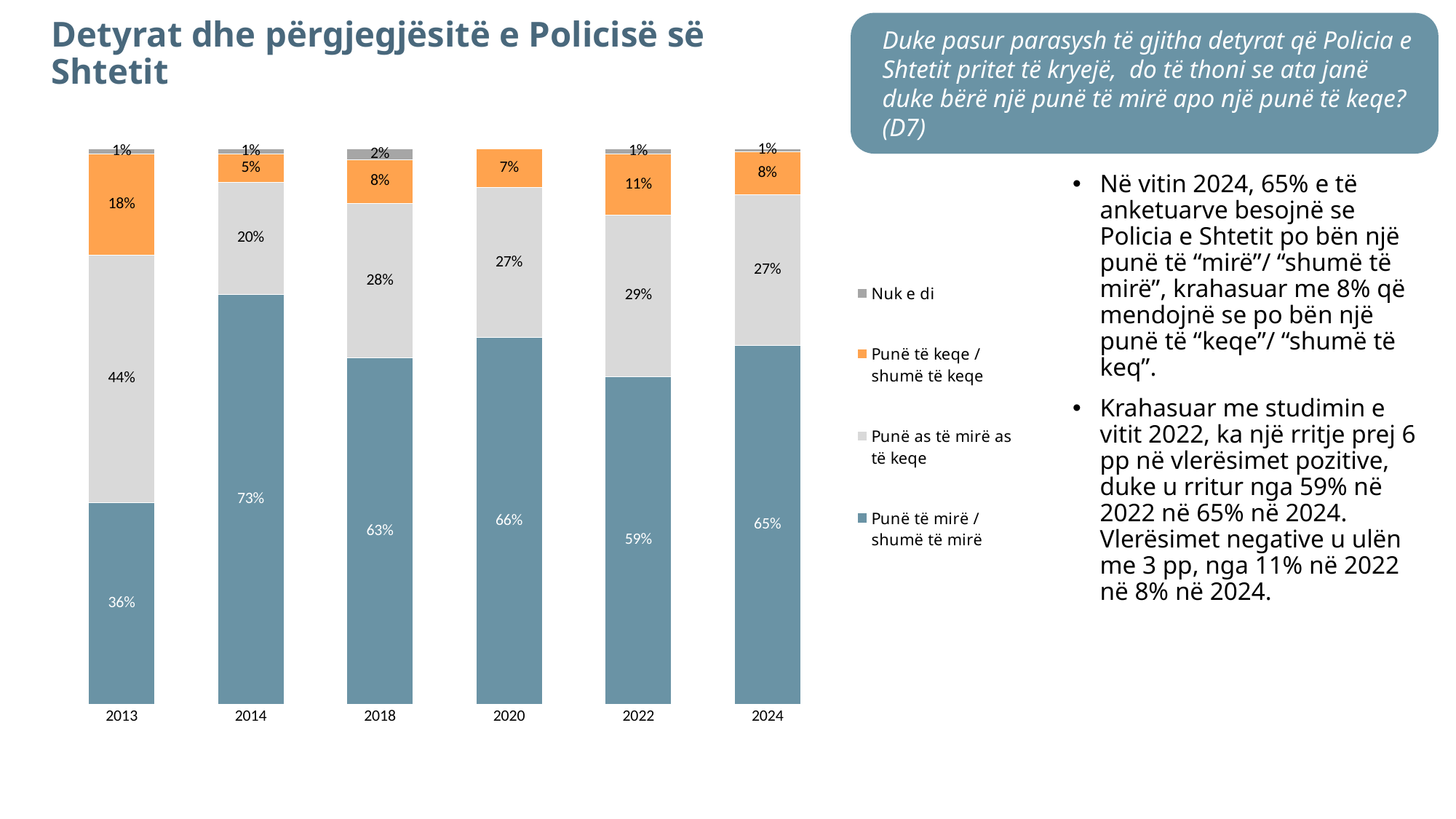
Which colour represents 'Punë të keqe / shumë të keqe' in the chart? Orange In which year is the 'Punë të mirë / shumë të mirë' share the highest? 2014 How many series does the legend list? 4 What is the value for 'Nuk e di' in 2018? 2% How many years are shown on the x axis of the chart? 6 What is the value for 'Punë të keqe / shumë të keqe' in 2013? 18% What is the value for 'Punë as të mirë as të keqe' in 2018? 28% What is the difference between the 'Punë të mirë / shumë të mirë' values for 2024 and 2022? 6 percentage points In which year is the 'Punë të mirë / shumë të mirë' share the lowest? 2013 Which year has a larger 'Punë të keqe / shumë të keqe' value, 2022 or 2020? 2022 What kind of chart is shown on the slide? Stacked bar chart What percentage of respondents in 2024 said the State Police is doing 'Punë të mirë / shumë të mirë'? 65%